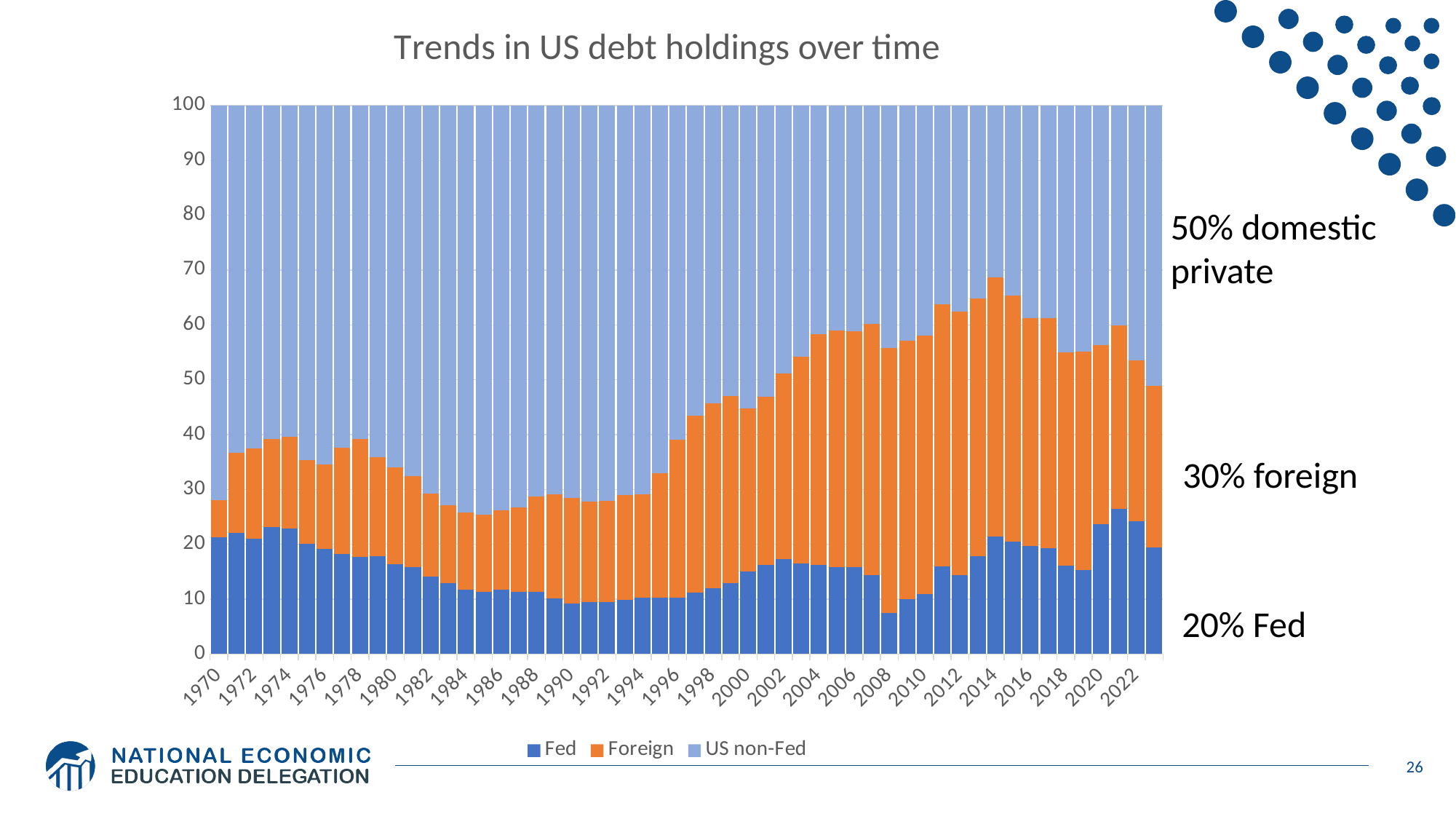
Is the Fed share larger in 1970 or in 1990? 1970 Is the top of the Foreign segment in 2014 greater or less than 60? greater How many series does the chart's legend list? 3 Does the Foreign share rise or fall from 1994 to 2014? rise What is the title of the chart? Trends in US debt holdings over time Is the top of the Foreign segment in 1985 greater or less than 30? less Which year has the lowest Fed share? 2008 What kind of chart is shown on the slide? Stacked bar chart Which year has the highest Fed share? 2021 Is the Fed share in 2021 greater or less than 20? greater What are the three series named in the legend? Fed, Foreign, US non-Fed